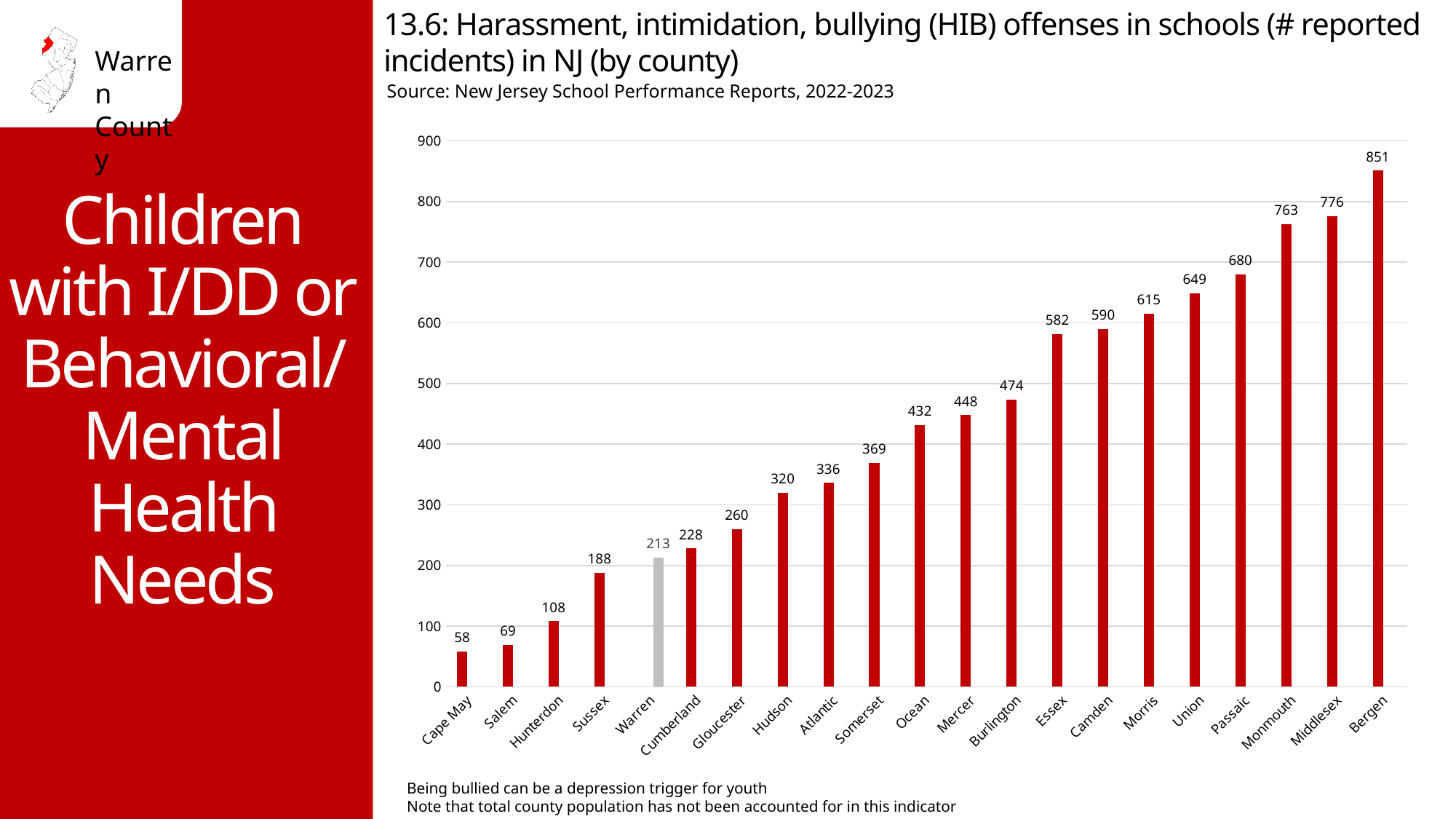
Which county has the lowest number of reported HIB incidents? Cape May Is the value for Monmouth greater or less than 700? greater What is the number of reported HIB incidents for Bergen county? 851 What is the number of reported HIB incidents for Hudson county? 320 How many counties are shown on the chart? 21 Which county has more reported HIB incidents, Essex or Camden? Camden What is the difference in reported HIB incidents between Warren and Sussex? 25 Which county has the highest number of reported HIB incidents? Bergen What is the number of reported HIB incidents for Warren county? 213 Which county's bar is shown in grey rather than red? Warren What kind of chart is shown on the slide? Bar chart What is the difference in reported HIB incidents between Bergen and Cape May? 793